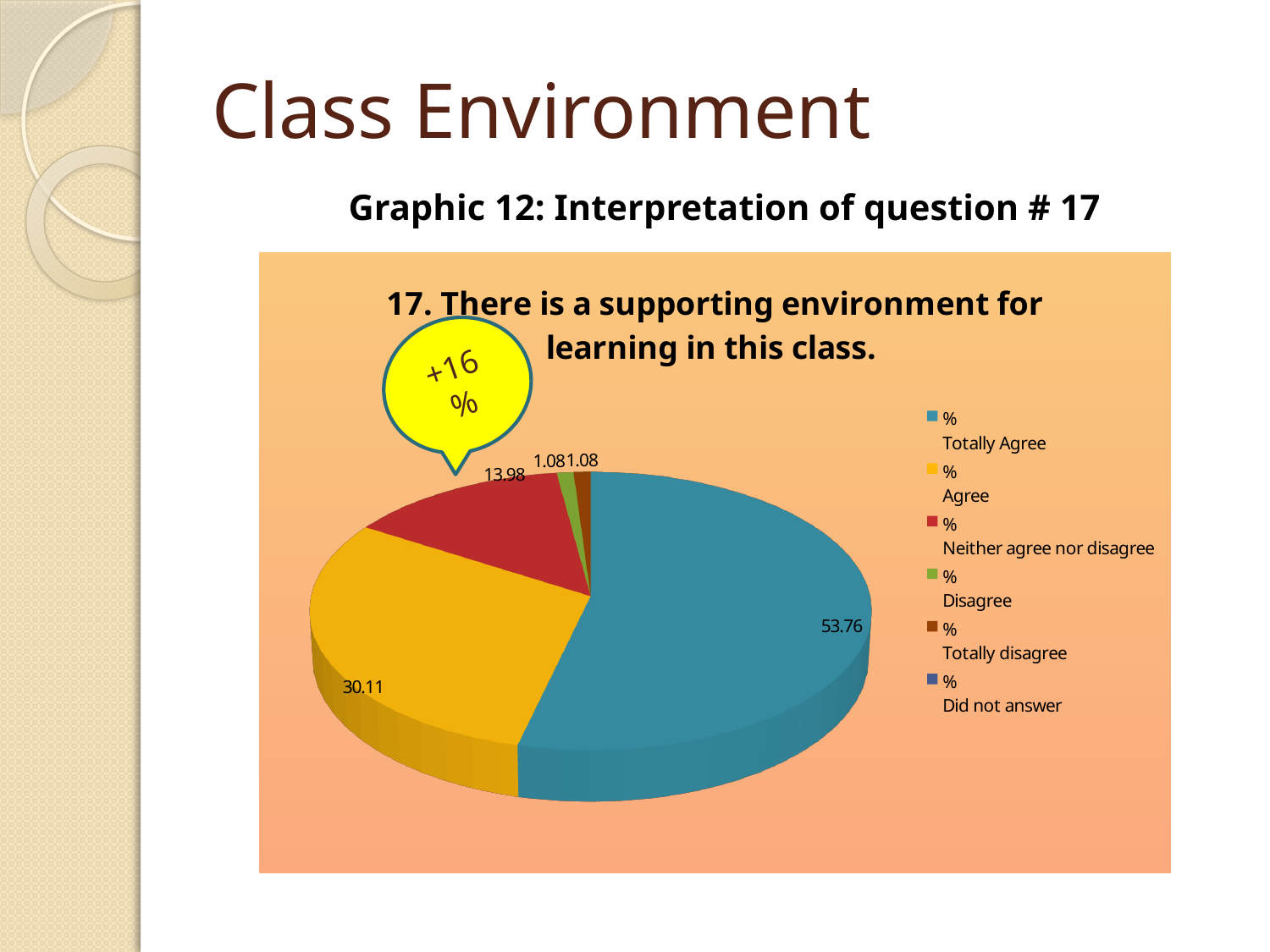
How many entries does the legend list? 6 What is the title of the chart? 17. There is a supporting environment for learning in this class. What is the value for Disagree? 1.08 What is the value for Totally Agree? 53.76 Which is larger, the value for Agree or the value for Neither agree nor disagree? Agree What is the value for Agree? 30.11 What is the value for Neither agree nor disagree? 13.98 What is the difference between the values for Agree and Neither agree nor disagree? 16.13 Which category has the largest slice of the pie? Totally Agree What is the difference between the values for Totally Agree and Agree? 23.65 What kind of chart is shown on the slide? pie chart What colour is the slice for Agree? yellow